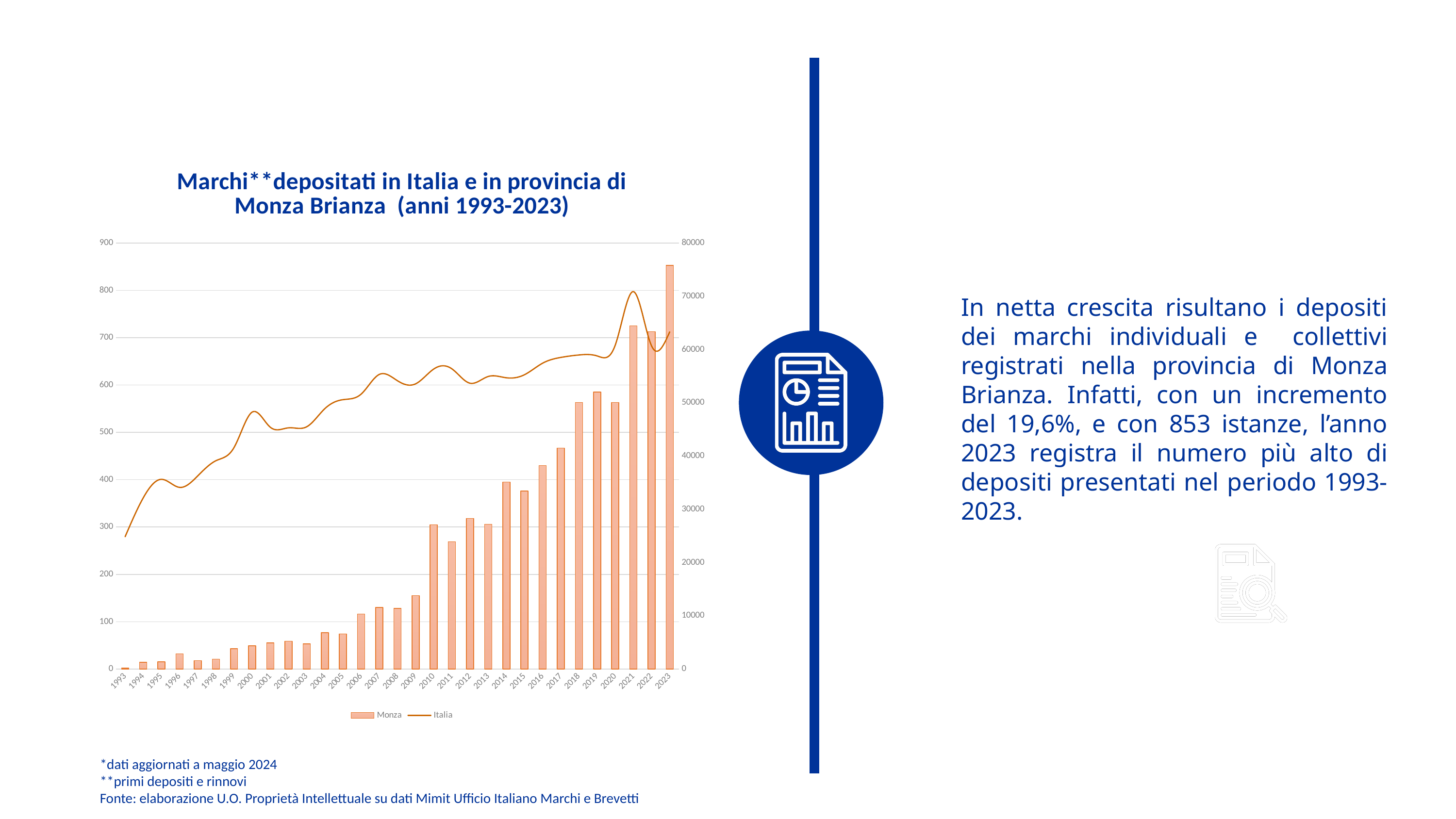
How many years are shown on the x axis? 31 Do the Monza bars generally rise or fall from 1993 to 2023? rise How many series does the legend list? 2 In which year is the Monza bar highest? 2023 In which year is the Monza bar lowest? 1993 Which year has the larger Monza bar, 2011 or 2012? 2012 What are the two series named in the legend? Monza and Italia In which year does the Italia line reach its peak? 2021 Is the Monza value for 2023 greater or less than 800? greater Is the Monza value for 2018 greater or less than 500? greater Is the Italia value for 1993 greater or less than 30000? less What kind of chart is shown on the slide? A combination bar and line chart